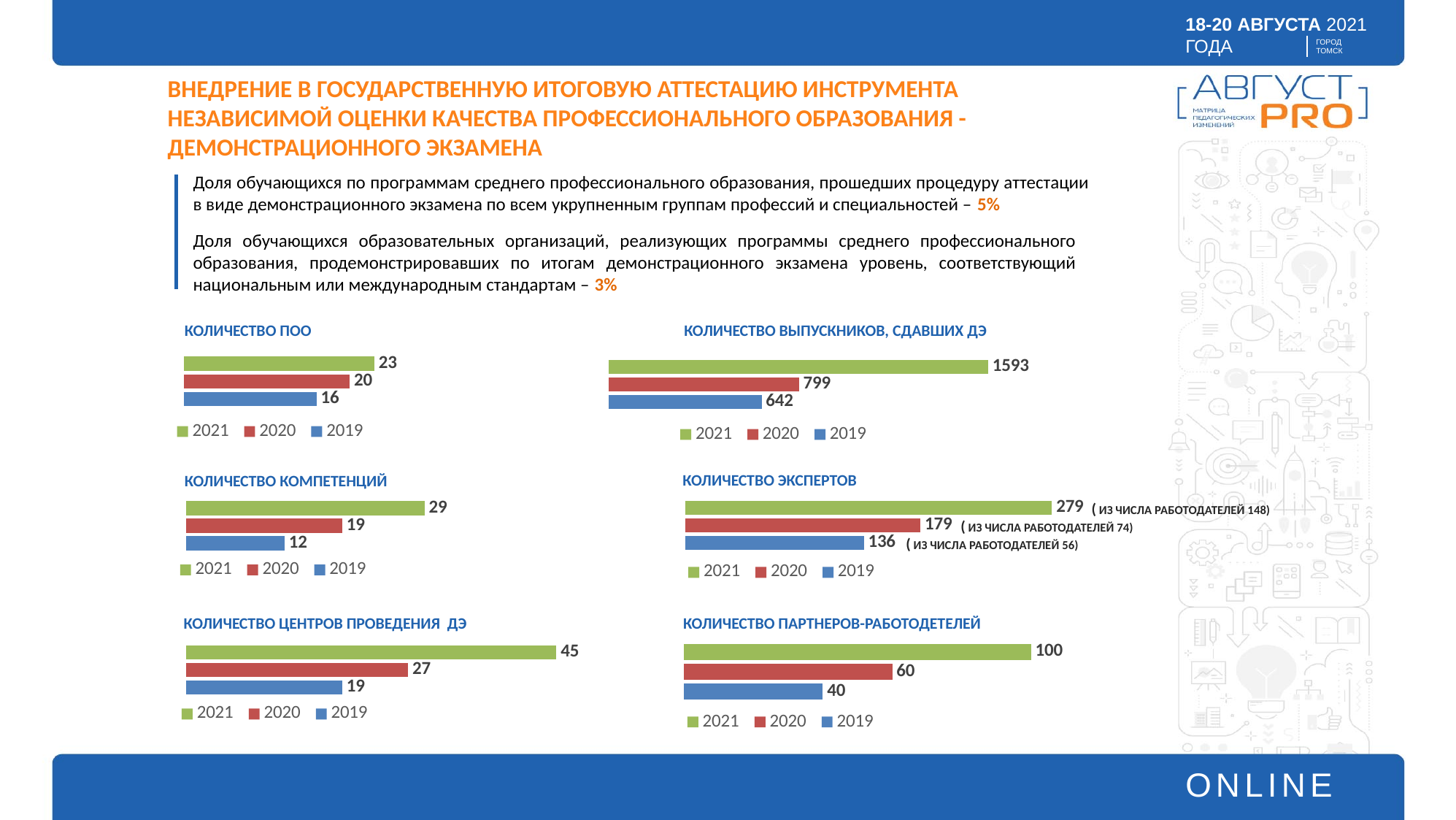
In the chart titled 'КОЛИЧЕСТВО ЭКСПЕРТОВ', which colour represents 2019? Blue In the chart titled 'КОЛИЧЕСТВО ВЫПУСКНИКОВ, СДАВШИХ ДЭ', what is the value for 2019? 642 What kind of chart is the one titled 'КОЛИЧЕСТВО ЭКСПЕРТОВ'? Bar chart In the chart titled 'КОЛИЧЕСТВО ПАРТНЕРОВ-РАБОТОДЕТЕЛЕЙ', which is larger, the value for 2020 or the value for 2019? 2020 In the chart titled 'КОЛИЧЕСТВО ЭКСПЕРТОВ', what is the difference between the 2021 and 2020 values? 100 How many series does the legend list in the chart titled 'КОЛИЧЕСТВО ПОО'? 3 In the chart titled 'КОЛИЧЕСТВО ВЫПУСКНИКОВ, СДАВШИХ ДЭ', which year has the highest value? 2021 In the chart titled 'КОЛИЧЕСТВО КОМПЕТЕНЦИЙ', do the values rise or fall from 2019 to 2021? Rise In the chart titled 'КОЛИЧЕСТВО ПОО', what is the value for 2021? 23 In the chart titled 'КОЛИЧЕСТВО ЦЕНТРОВ ПРОВЕДЕНИЯ ДЭ', what is the value for 2020? 27 In the chart titled 'КОЛИЧЕСТВО КОМПЕТЕНЦИЙ', which year has the lowest value? 2019 In the chart titled 'КОЛИЧЕСТВО ПАРТНЕРОВ-РАБОТОДЕТЕЛЕЙ', what is the difference between the 2021 and 2019 values? 60